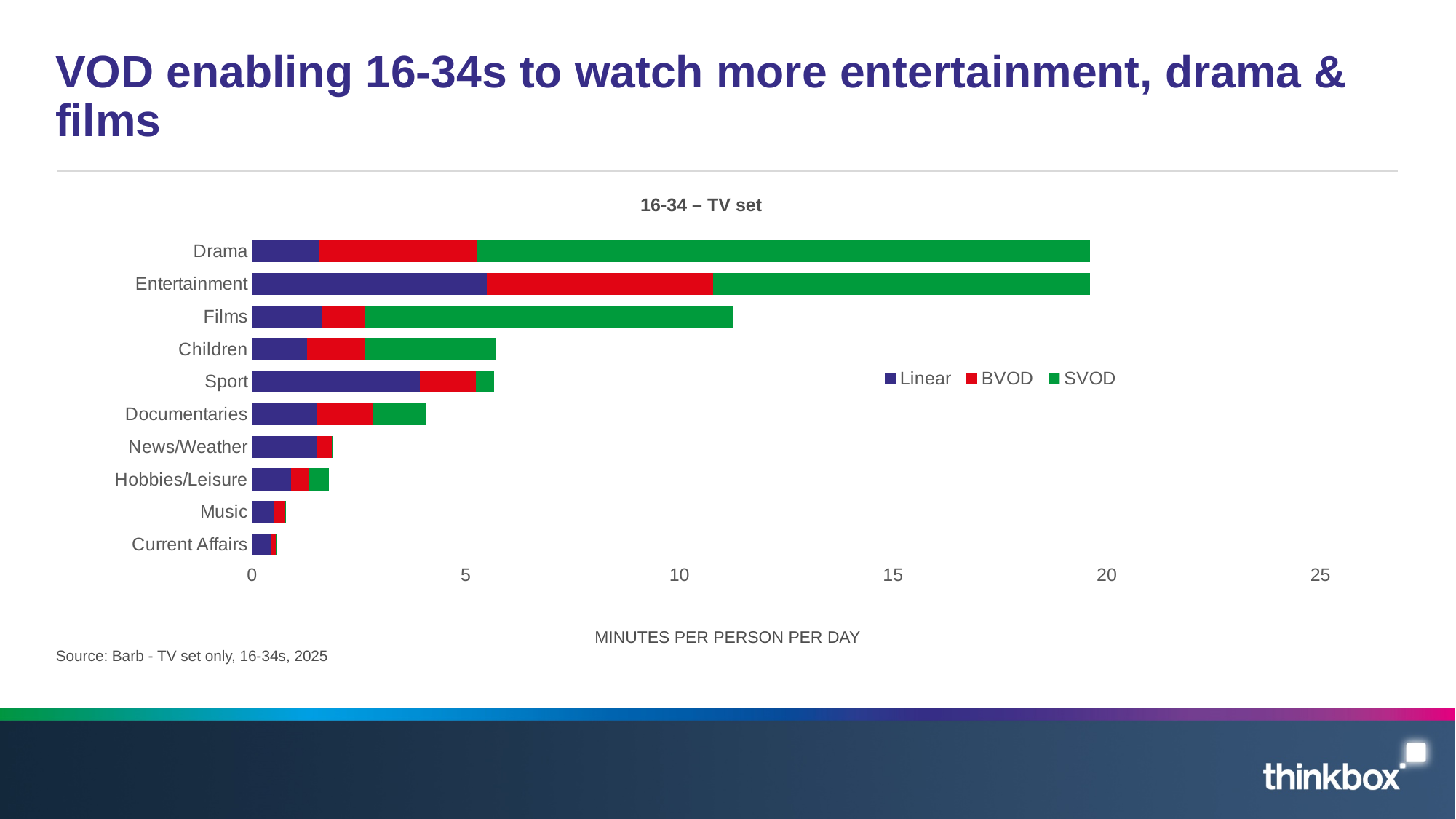
Which has a larger total, Films or Children? Films How many series does the legend list? 3 Is the Linear segment for Entertainment greater or less than 5? greater Is the total value for Films greater or less than 10? greater What kind of chart is shown on the slide? Stacked bar chart Which has a larger total, Sport or Documentaries? Sport How many categories (genres) are plotted on the chart? 10 What is the label on the horizontal axis of the chart? MINUTES PER PERSON PER DAY Which category has the lowest total minutes per person per day? Current Affairs Is the total value for Documentaries greater or less than 5? less What are the three series named in the legend? Linear, BVOD, SVOD